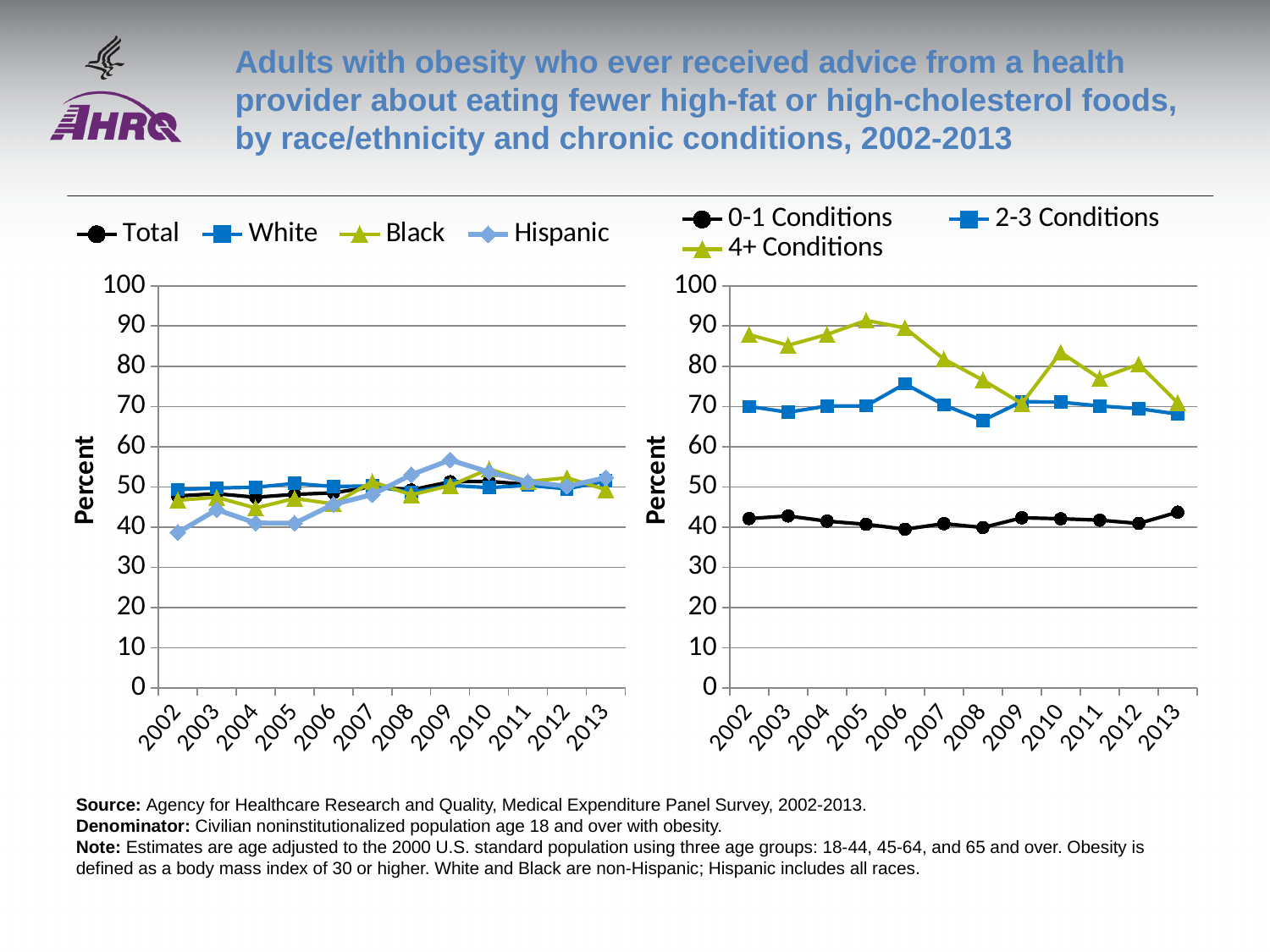
How many series does the legend of the right chart (by chronic conditions) list? 3 In the right chart (by chronic conditions), is the value for 2-3 Conditions in 2006 greater or less than 70? greater In the right chart (by chronic conditions), is the value for 0-1 Conditions in 2006 greater or less than 50? less What kind of chart is the left chart, showing results by race/ethnicity? line chart In the right chart (by chronic conditions), does the 4+ Conditions line rise or fall from 2005 to 2008? fall How many series does the legend of the left chart (by race/ethnicity) list? 4 In the left chart (by race/ethnicity), is the value for Hispanic in 2009 greater or less than 50? greater How many years are plotted along the x axis of the right chart (by chronic conditions)? 12 In the left chart (by race/ethnicity), which series has the lowest value in 2002? Hispanic In the right chart (by chronic conditions), which series has the highest value in 2005? 4+ Conditions